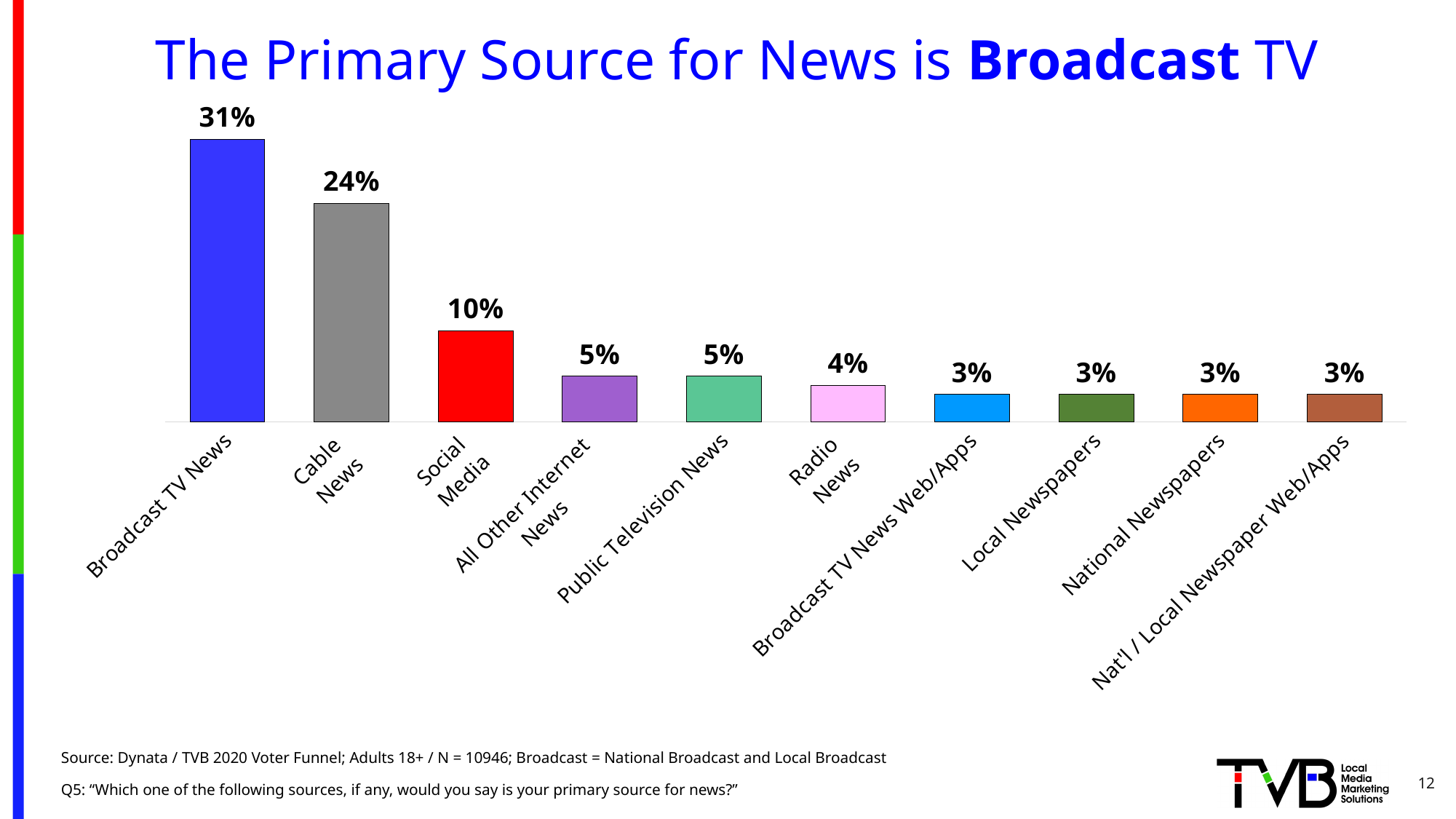
What colour is the bar for Broadcast TV News? Blue What is the value shown for Social Media? 10% What percentage of respondents named Broadcast TV News as their primary source for news? 31% Which has a larger value, Social Media or Public Television News? Social Media What is the difference between the values for Broadcast TV News and Cable News? 7% What is the difference between the values for Cable News and Social Media? 14% What is the value shown for Cable News? 24% Which news source has the highest value in the chart? Broadcast TV News What is the value shown for Radio News? 4% Which has a larger value, Radio News or Local Newspapers? Radio News What kind of chart is shown on the slide? Bar chart How many news source categories are shown in the chart? 10